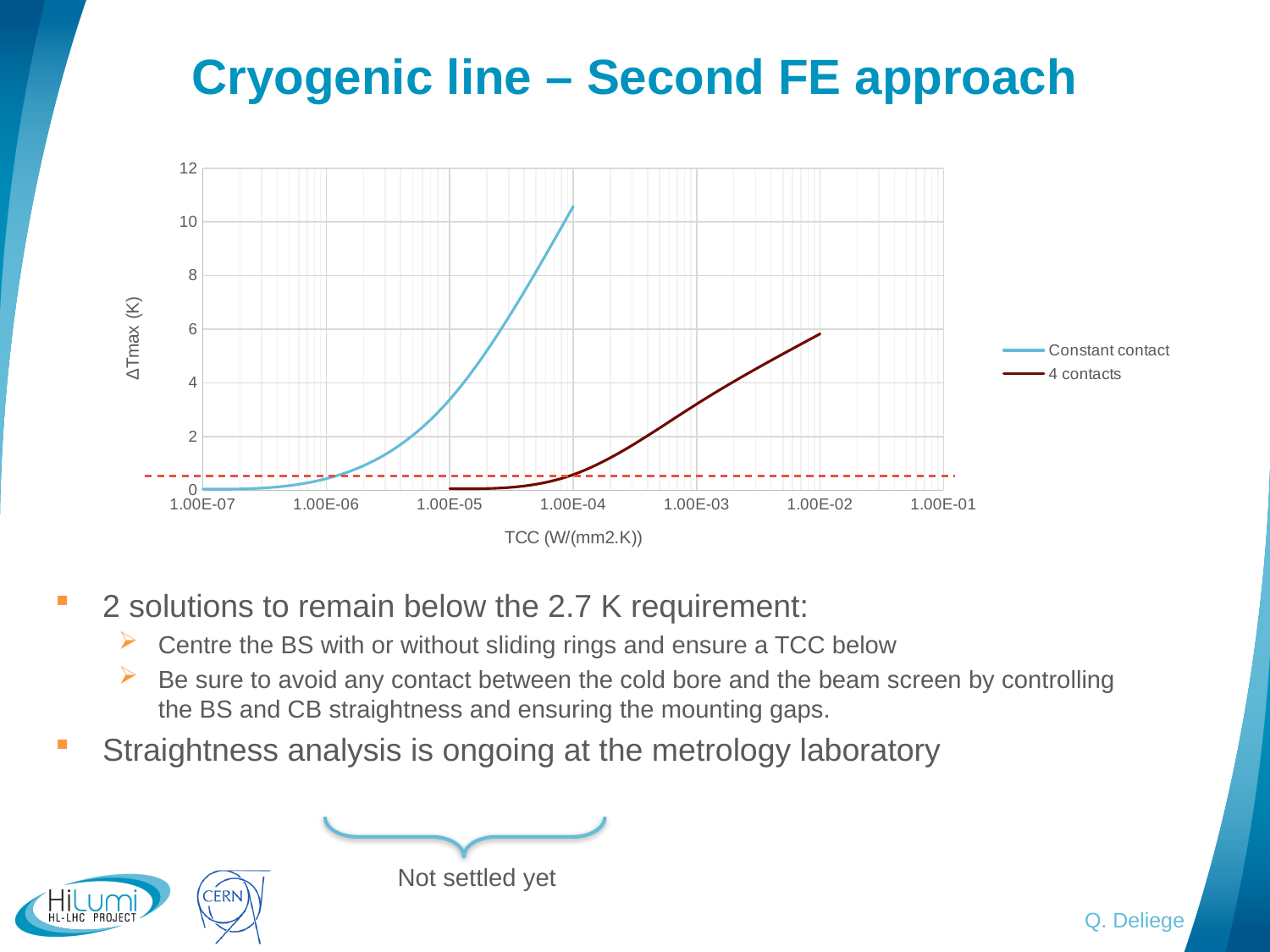
Is the value of the Constant contact curve at TCC = 1.00E-05 greater or less than 6? less Is the value of the Constant contact curve at TCC = 1.00E-04 greater or less than 10? greater Is the value of the 4 contacts curve at TCC = 1.00E-02 greater or less than 4? greater Does the 4 contacts curve rise or fall as TCC increases along the x axis? rise What kind of chart is shown on the slide? line chart What are the two series named in the chart legend? Constant contact and 4 contacts How many tick labels are shown on the chart's x axis? 7 How many series does the chart legend list? 2 At TCC = 1.00E-04, which series has the larger ΔTmax value, Constant contact or 4 contacts? Constant contact Does the Constant contact curve rise or fall as TCC increases along the x axis? rise What is the label of the chart's y axis? ΔTmax (K) Which series reaches the highest ΔTmax value on the chart? Constant contact